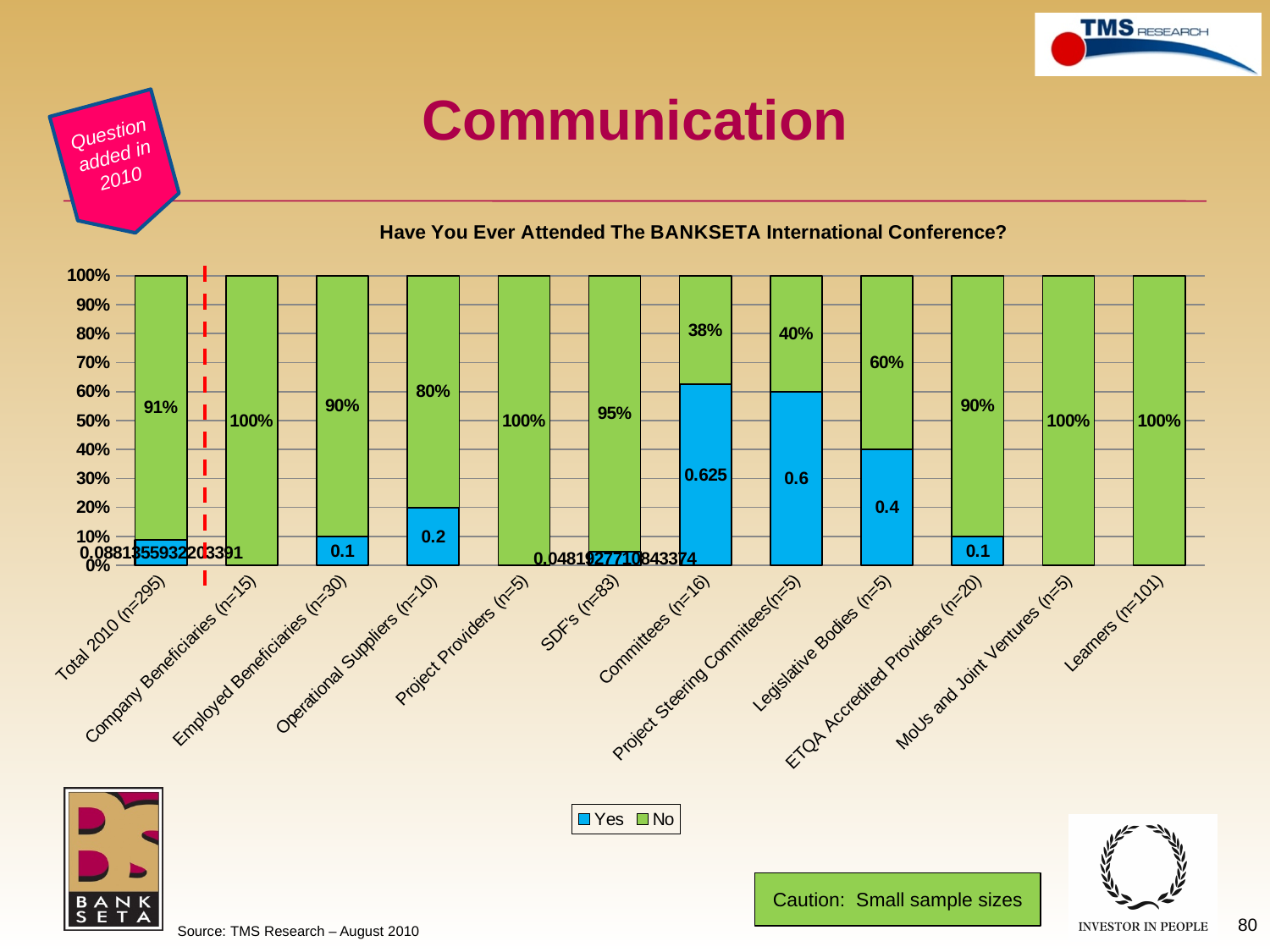
Which category has the lowest 'No' value? Committees (n=16) What is the difference between the 'No' value for Legislative Bodies (n=5) and the 'No' value for Project Steering Committees (n=5)? 20% What is the 'No' value for Operational Suppliers (n=10)? 80% Is the 'Yes' value for Legislative Bodies (n=5) greater or less than 50%? less What is the 'Yes' value for Committees (n=16)? 0.625 Which category has the highest 'Yes' value? Committees (n=16) What is the 'Yes' value for ETQA Accredited Providers (n=20)? 0.1 Which is larger: the 'Yes' value for Committees (n=16) or for Project Steering Committees (n=5)? Committees (n=16) What type of chart is shown on the slide? Stacked bar chart How many categories are shown on the x axis of the chart? 12 How many series does the legend list? 2 What is the 'No' value for Committees (n=16)? 38%